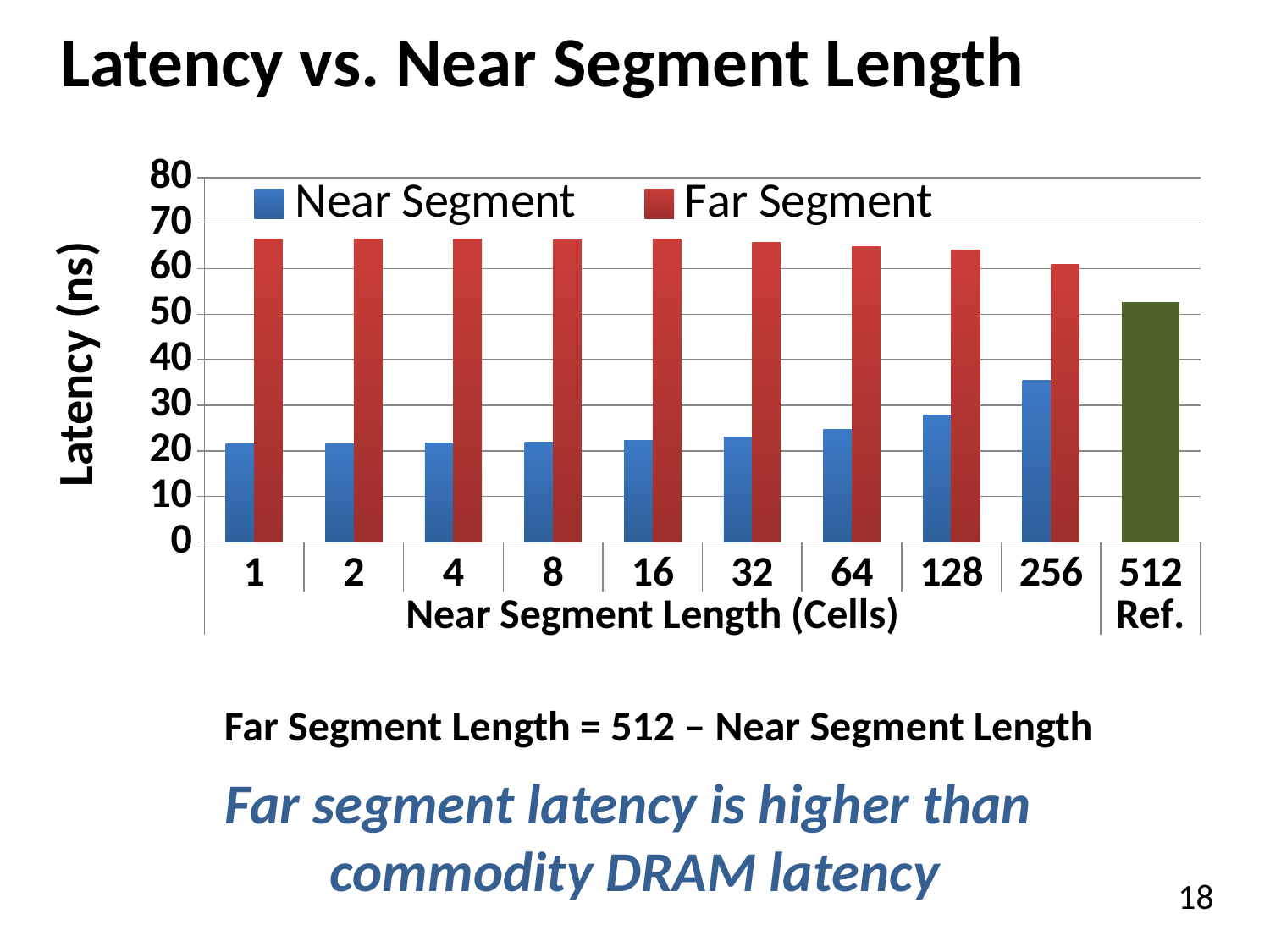
At which near segment length is the Near Segment latency highest? 256 At which near segment length is the Far Segment latency lowest? 256 Is the Near Segment latency at near segment length 1 greater or less than 30? less What kind of chart is shown on the slide? bar chart How many series does the legend list? 2 What is the title of the chart? Latency vs. Near Segment Length What is the label of the y axis? Latency (ns) Which is larger at near segment length 256: the Far Segment latency or the 512 Ref. latency? Far Segment Is the latency of the 512 Ref. bar greater or less than 60? less How many categories are shown along the x axis? 10 Is the Far Segment latency at near segment length 1 greater or less than 60? greater